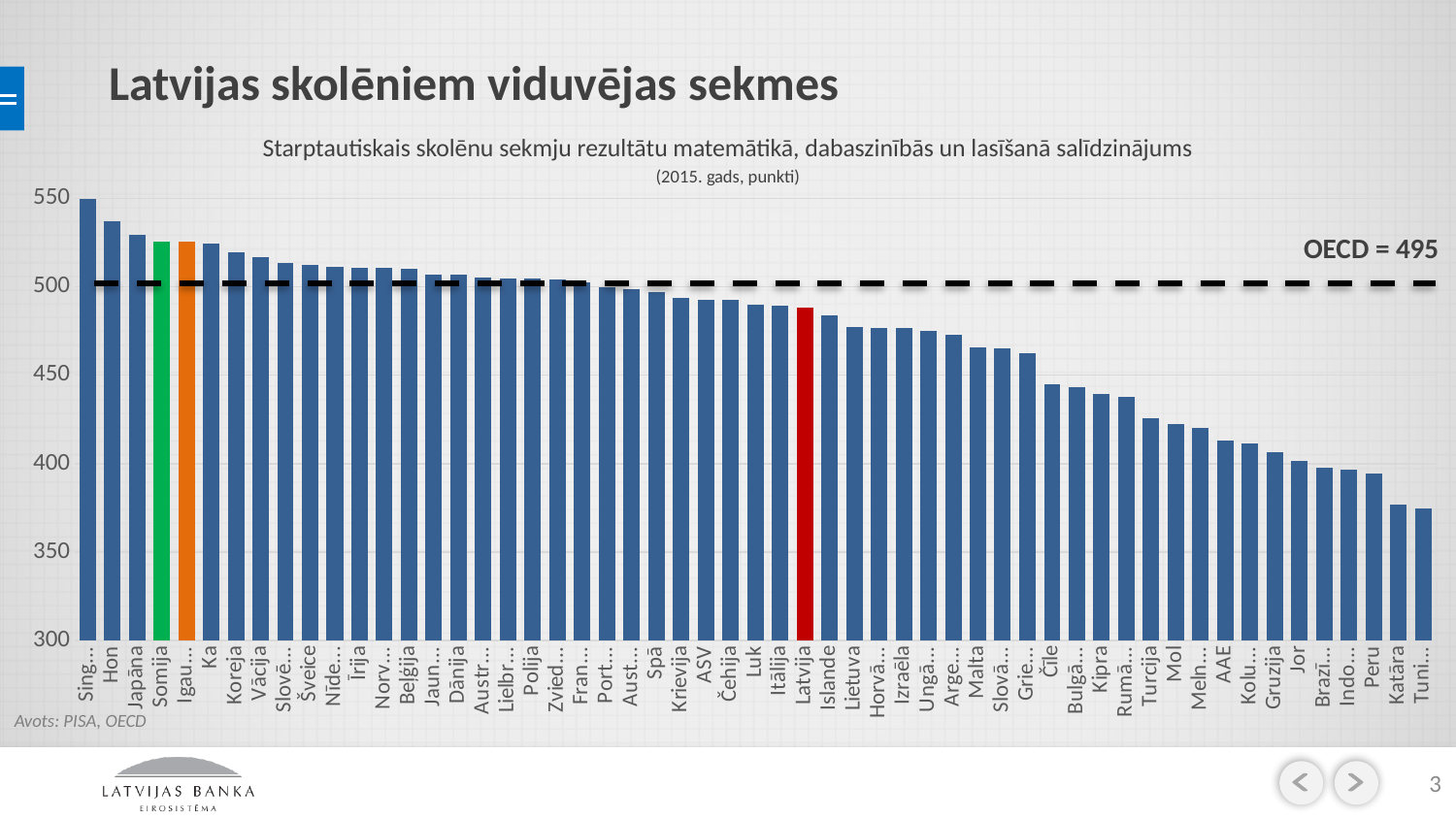
Which has a higher value, Somija or Latvija? Somija Is the value for Turcija greater or less than 450? less Do the bar values rise or fall from left to right along the x axis? fall Is the value for Čīle greater or less than 450? less What OECD average value is printed on the chart? 495 Which country has the lowest bar in the chart? Tuni... Is the value for Japāna greater or less than 500? greater Which country has the highest bar in the chart? Sing... What kind of chart is shown on the slide? bar chart Which has a higher value, Koreja or Čīle? Koreja